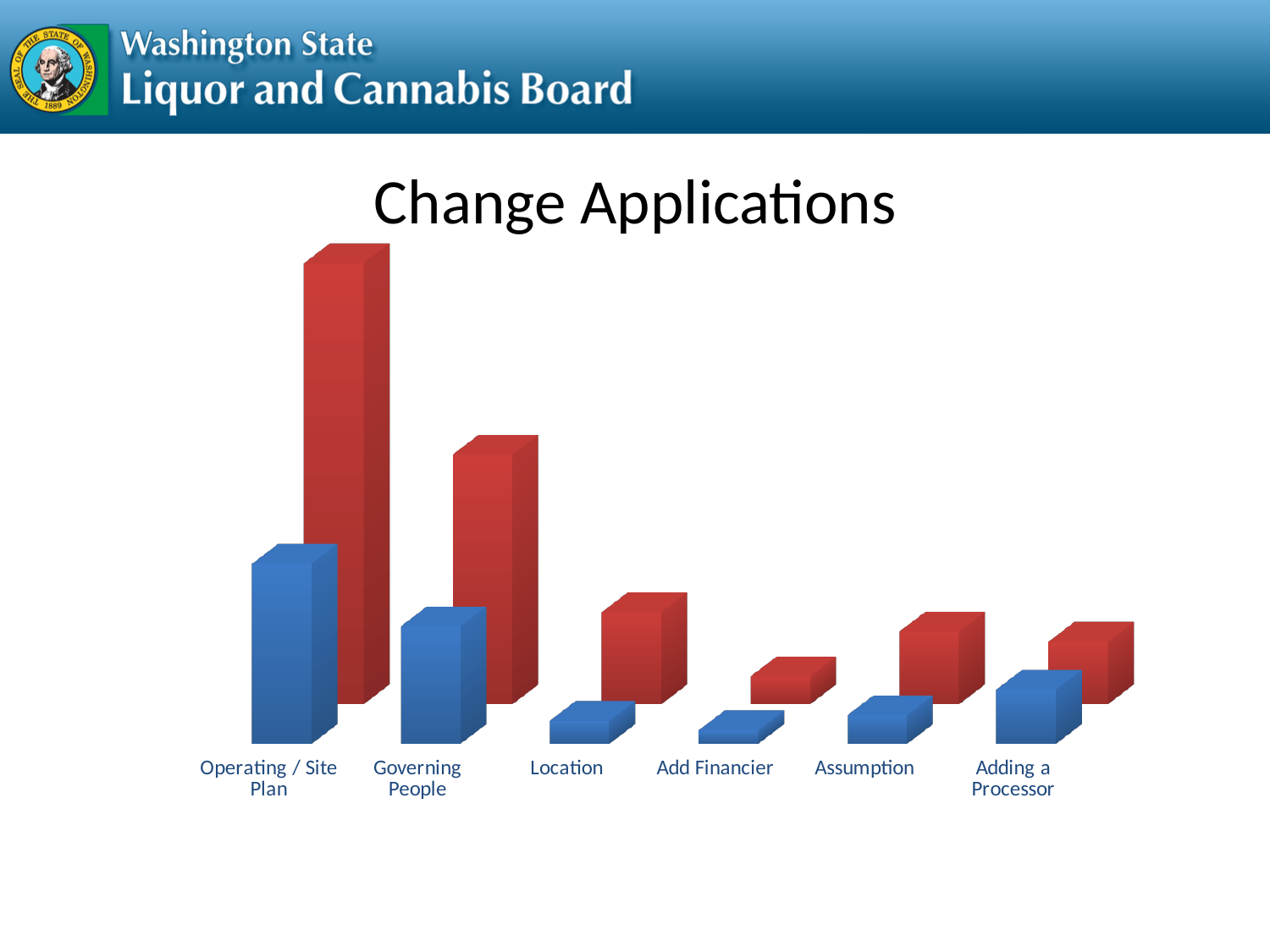
Which has the taller red bar, Governing People or Location? Governing People For the Location category, which bar is taller, the red one or the blue one? the red one Which category has the shortest blue bar? Add Financier Which has the taller blue bar, Operating / Site Plan or Governing People? Operating / Site Plan Which category has the tallest blue bar? Operating / Site Plan How many categories are shown along the x axis of the chart? 6 What kind of chart is shown on the slide? bar chart Which category has the tallest red bar? Operating / Site Plan What is the title of the chart? Change Applications What two colours are used for the bars in the chart? blue and red Which category has the shortest red bar? Add Financier